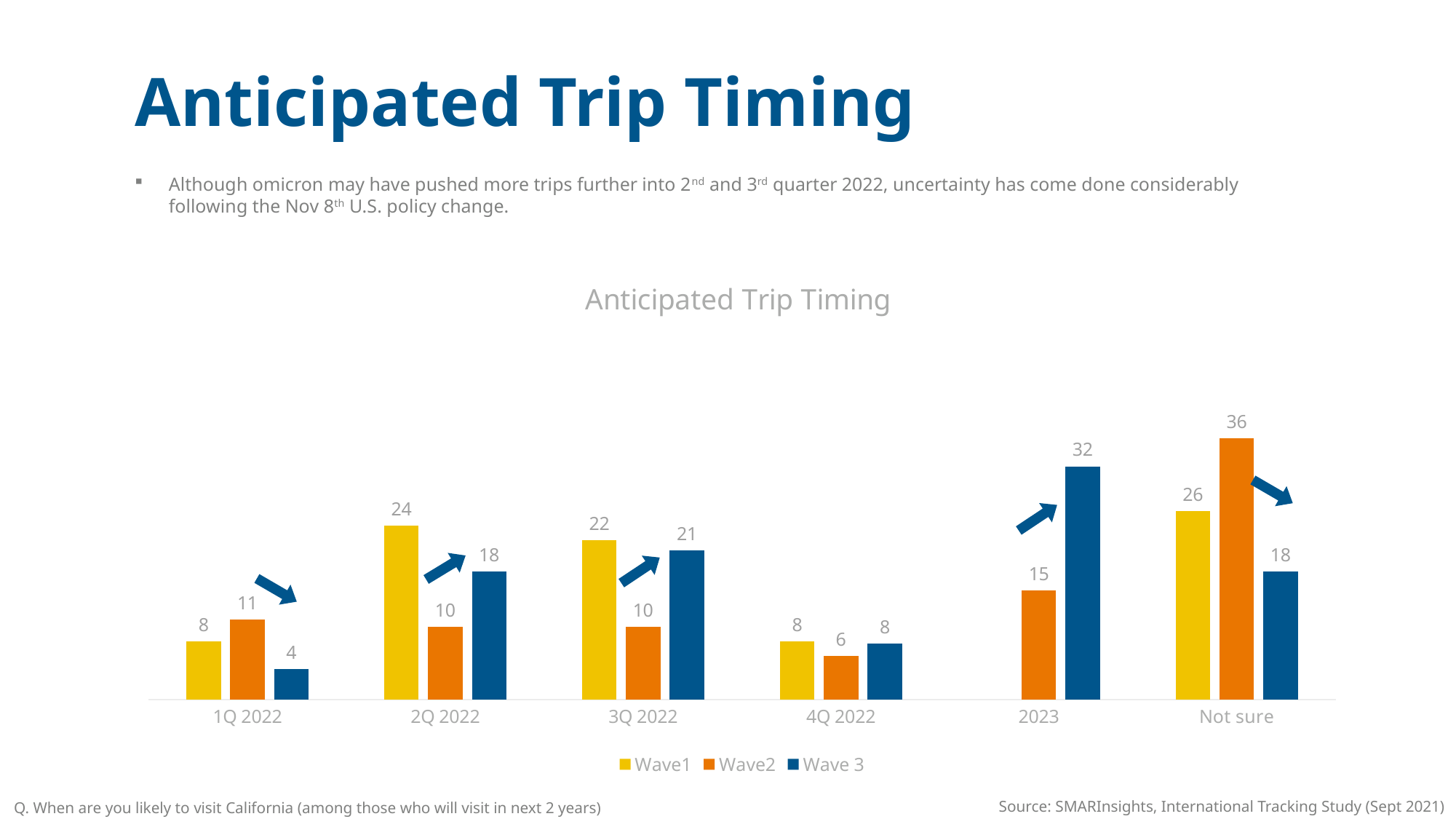
What is the title of the chart? Anticipated Trip Timing What is the difference between the Wave1 and Wave 3 values for Not sure? 8 What is the Wave2 value for Not sure? 36 What is the Wave1 value for 3Q 2022? 22 What is the difference between the Wave 3 and Wave2 values for 2023? 17 What kind of chart is shown on the slide? Bar chart Which category has the lowest Wave 3 value? 1Q 2022 Which is larger for 1Q 2022, the Wave1 value or the Wave2 value? Wave2 Which category has the highest Wave 3 value? 2023 How many categories are shown on the x axis? 6 What is the Wave 3 value for 2Q 2022? 18 How many series does the legend list? 3